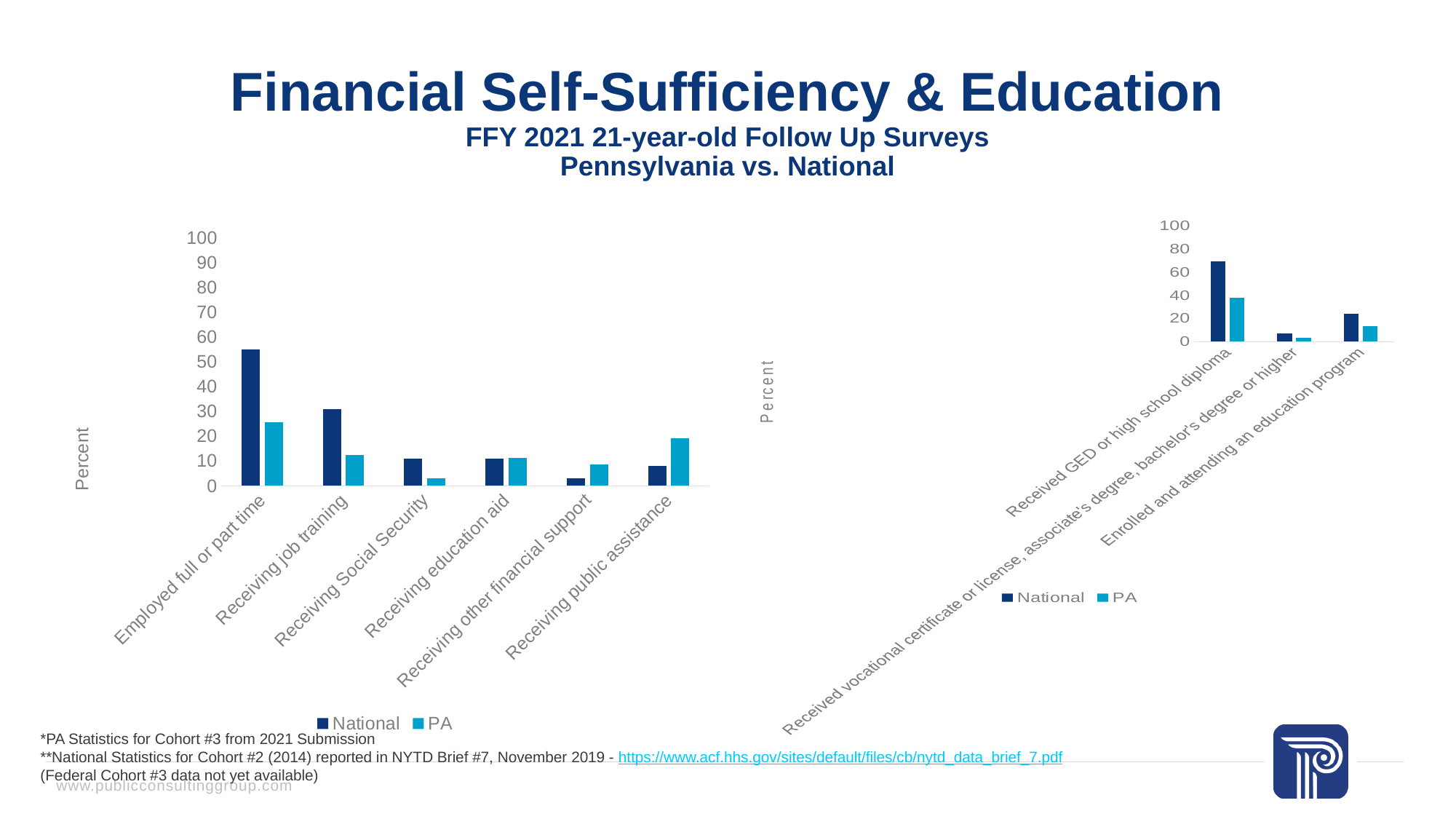
In the left chart, for Receiving public assistance, which is larger: National or PA? PA In the right chart, which category has the highest National value? Received GED or high school diploma In the left chart, is the PA value for Receiving Social Security greater or less than 10? less In the right chart, is the National value for Received GED or high school diploma greater or less than 60? greater How many categories are shown on the x axis of the right chart? 3 In the left chart, which category has the highest National value? Employed full or part time What are the two legend entries of the right chart? National and PA How many categories are shown on the x axis of the left chart? 6 What kind of chart is the left chart on the slide? bar chart In the left chart, is the National value for Employed full or part time greater or less than 50? greater How many series does the legend of the left chart list? 2